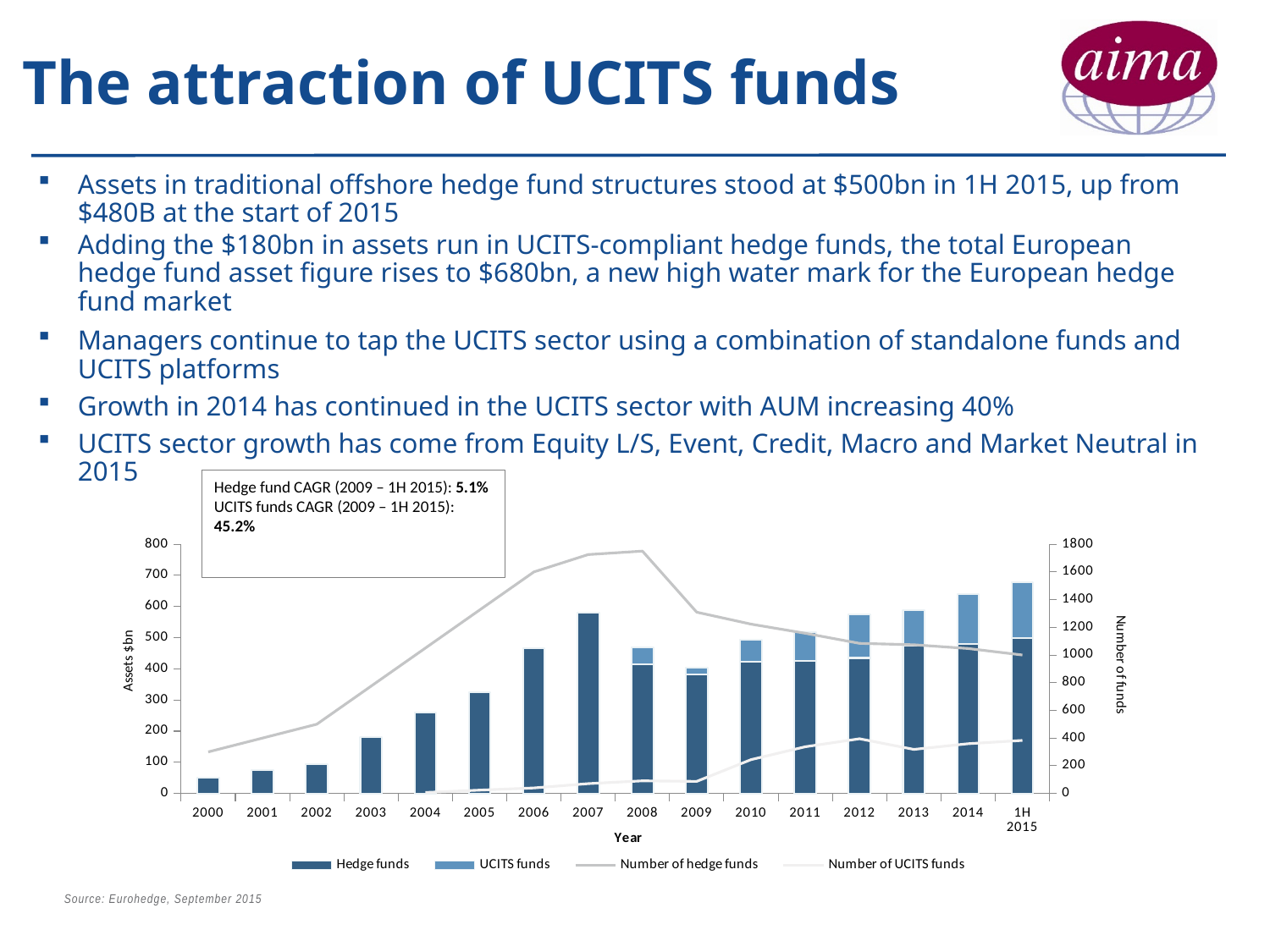
In which year is the total stacked bar the lowest? 2000 What kind of chart is shown on the slide? A bar chart with line series (combination chart) Is the Hedge funds value for 2007 greater or less than 500 $bn? greater Does the Number of hedge funds line rise or fall from 2008 to 1H 2015? fall What is the Hedge fund CAGR (2009 – 1H 2015) stated in the text box on the chart? 5.1% In which year is the Hedge funds bar (dark blue) the tallest? 2007 How many series does the chart legend list? 4 How many year categories are shown on the x axis of the chart? 16 Is the Number of hedge funds in 2008 greater or less than 1600? greater What is the UCITS funds CAGR (2009 – 1H 2015) stated in the text box on the chart? 45.2% Is the Hedge funds value for 2000 greater or less than 100 $bn? less Which year has the larger total stacked bar, 2007 or 2008? 2007